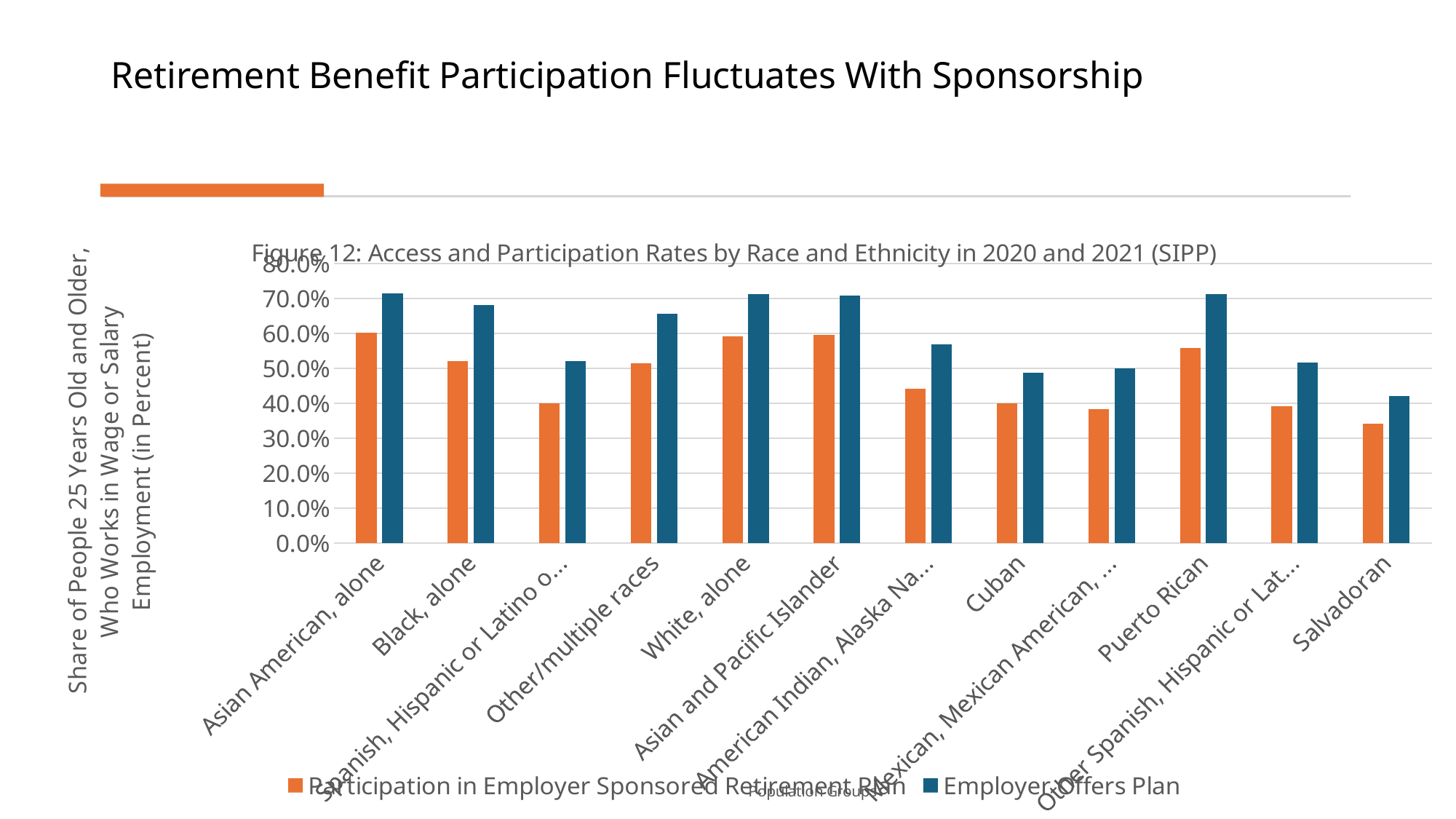
Is the Participation in Employer Sponsored Retirement Plan value for Cuban greater or less than 50.0%? less Which series is shown in orange in the chart's legend? Participation in Employer Sponsored Retirement Plan Which is larger: the Employer Offers Plan value for Asian American, alone or for Salvadoran? Asian American, alone Which population group has the lowest value for Participation in Employer Sponsored Retirement Plan? Salvadoran Is the Participation in Employer Sponsored Retirement Plan value for Salvadoran greater or less than 40.0%? less What kind of chart is shown on the slide? bar chart How many population groups are shown on the x axis of the chart? 12 Which population group has the lowest value for Employer Offers Plan? Salvadoran Which is larger: the Participation in Employer Sponsored Retirement Plan value for Black, alone or for Cuban? Black, alone Is the Employer Offers Plan value for Puerto Rican greater or less than 60.0%? greater How many series does the chart's legend list? 2